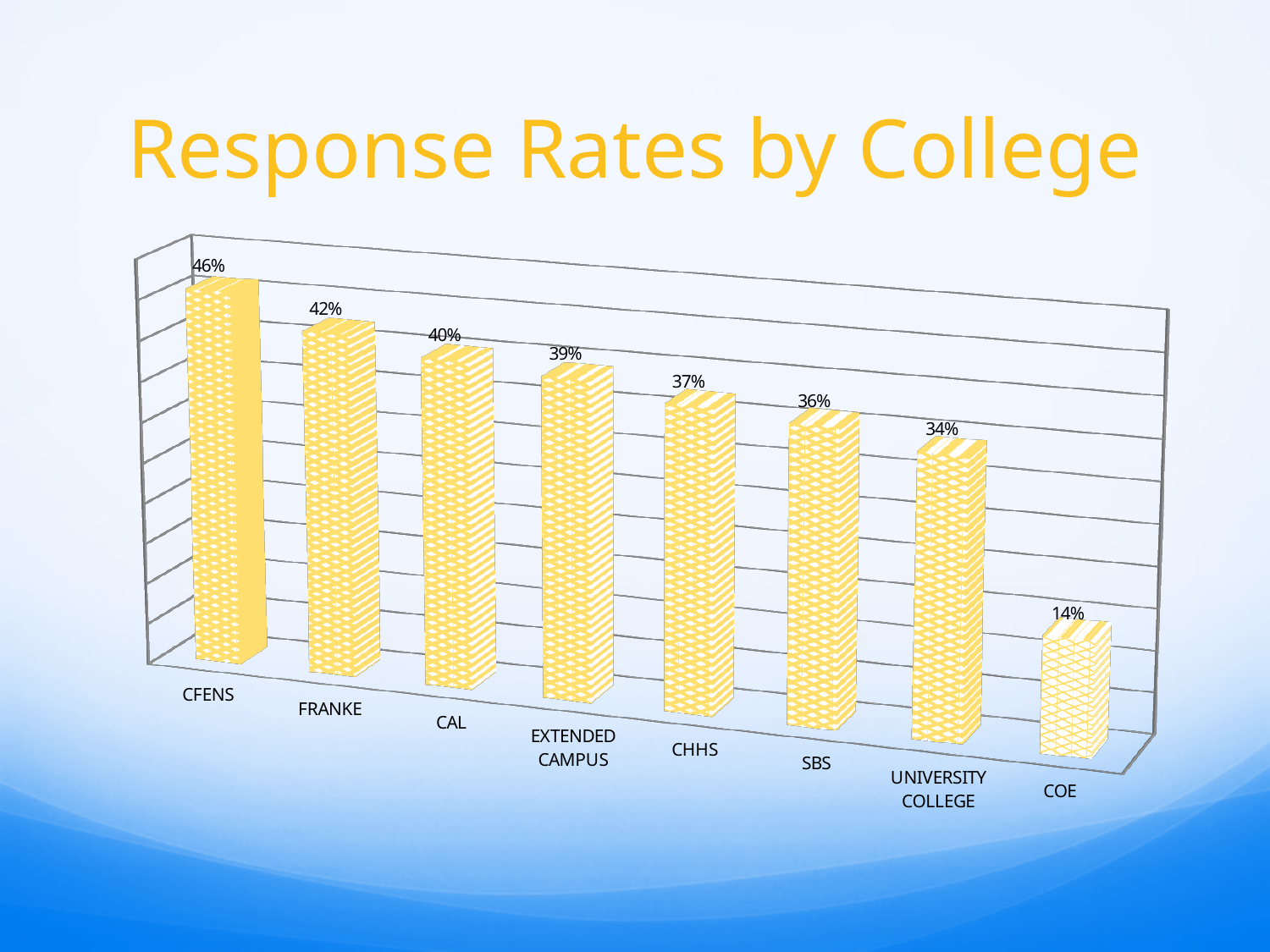
What is the difference between the response rates of FRANKE and SBS? 6% What kind of chart is shown on the slide? Bar chart Do the response rates rise or fall from left to right across the chart? Fall Which college has the lowest response rate? COE What is the response rate for CFENS? 46% What is the difference between the response rates of CFENS and COE? 32% How many colleges are shown in the chart? 8 What is the response rate for University College? 34% What is the response rate for Extended Campus? 39% Which college has the highest response rate? CFENS Which has a higher response rate, CAL or CHHS? CAL What is the title of the chart? Response Rates by College